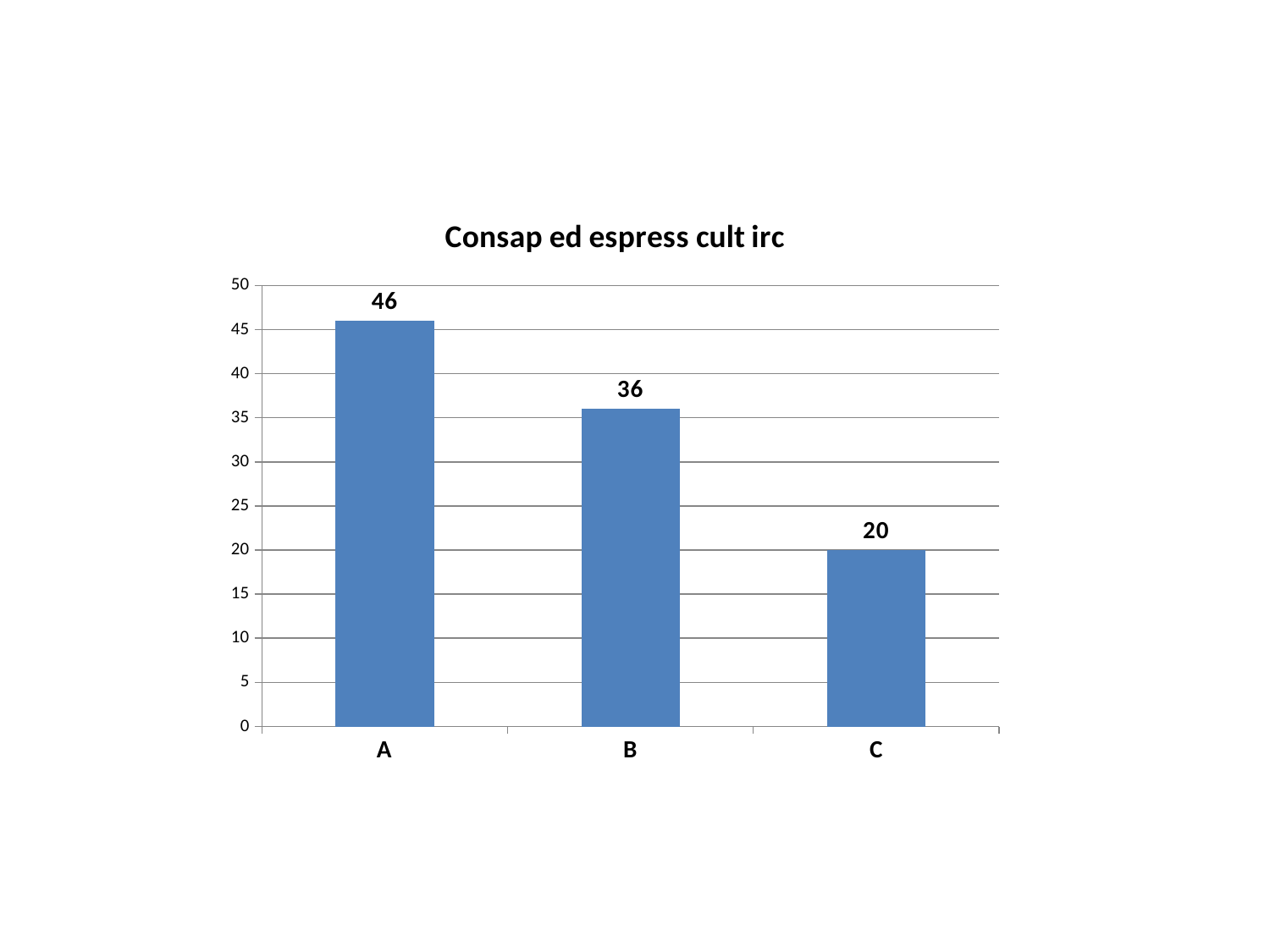
Which category has the highest value? A Which is larger, the value for A or the value for C? A Which category has the lowest value? C What is the difference between the values for A and B? 10 What is the value for category C? 20 Is the value for B greater or less than 30? greater What is the difference between the values for B and C? 16 What is the value for category A? 46 What is the value for category B? 36 What kind of chart is shown on the slide? bar chart Do the values rise or fall from A to C along the x axis? fall How many categories are shown on the x axis? 3